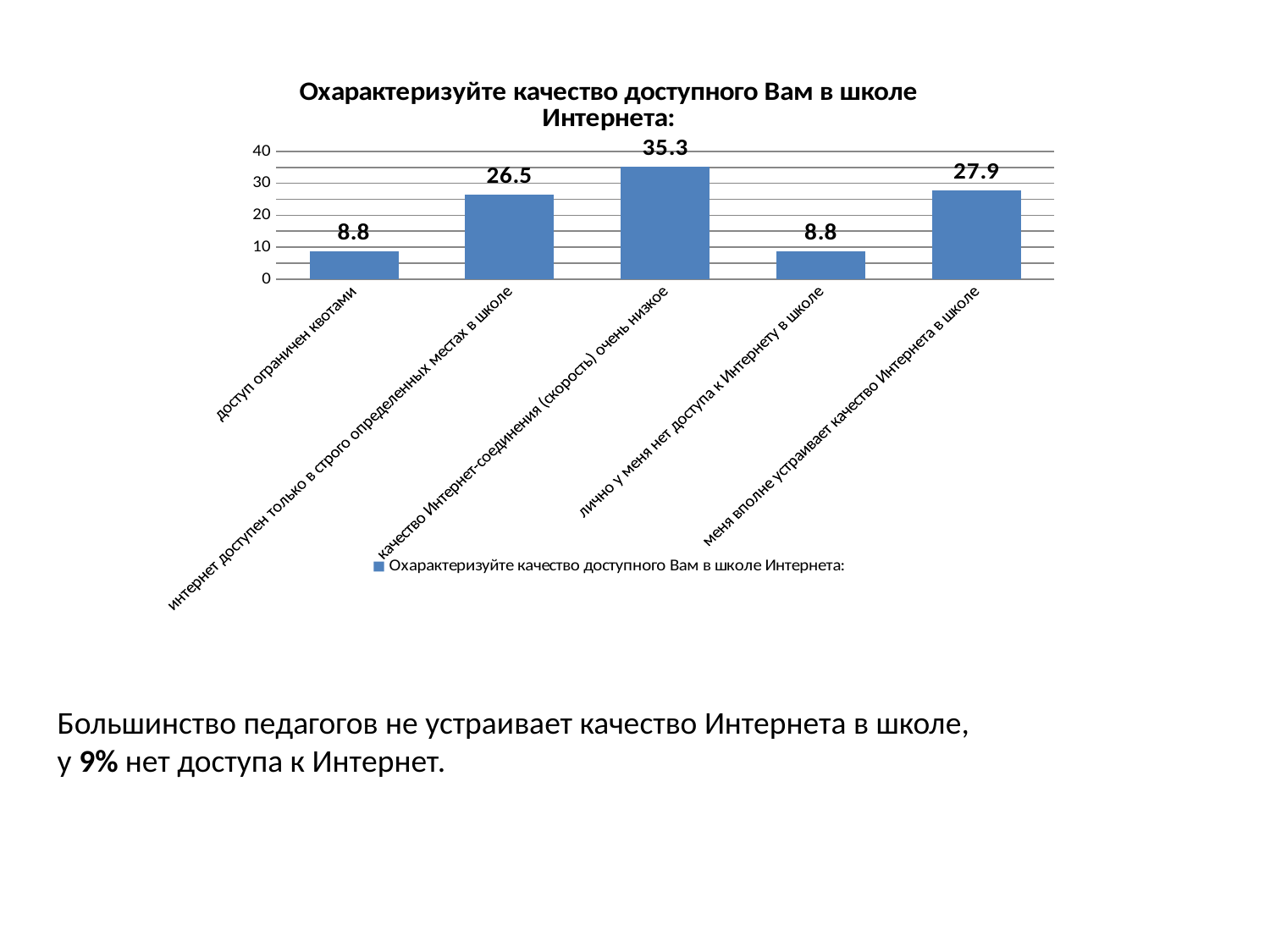
How many categories are shown on the chart? 5 What value is shown for "интернет доступен только в строго определенных местах в школе"? 26.5 What value is shown for the category "доступ ограничен квотами"? 8.8 What value is shown for "меня вполне устраивает качество Интернета в школе"? 27.9 What kind of chart is shown on the slide? bar chart Which category has the highest value? качество Интернет-соединения (скорость) очень низкое What is the difference between the values for "интернет доступен только в строго определенных местах в школе" and "лично у меня нет доступа к Интернету в школе"? 17.7 What is the difference between the values for "качество Интернет-соединения (скорость) очень низкое" and "меня вполне устраивает качество Интернета в школе"? 7.4 What is the title of the chart? Охарактеризуйте качество доступного Вам в школе Интернета: Is the value for "качество Интернет-соединения (скорость) очень низкое" greater or less than 30? greater Which is larger: the value for "меня вполне устраивает качество Интернета в школе" or for "интернет доступен только в строго определенных местах в школе"? меня вполне устраивает качество Интернета в школе What value is shown for "качество Интернет-соединения (скорость) очень низкое"? 35.3